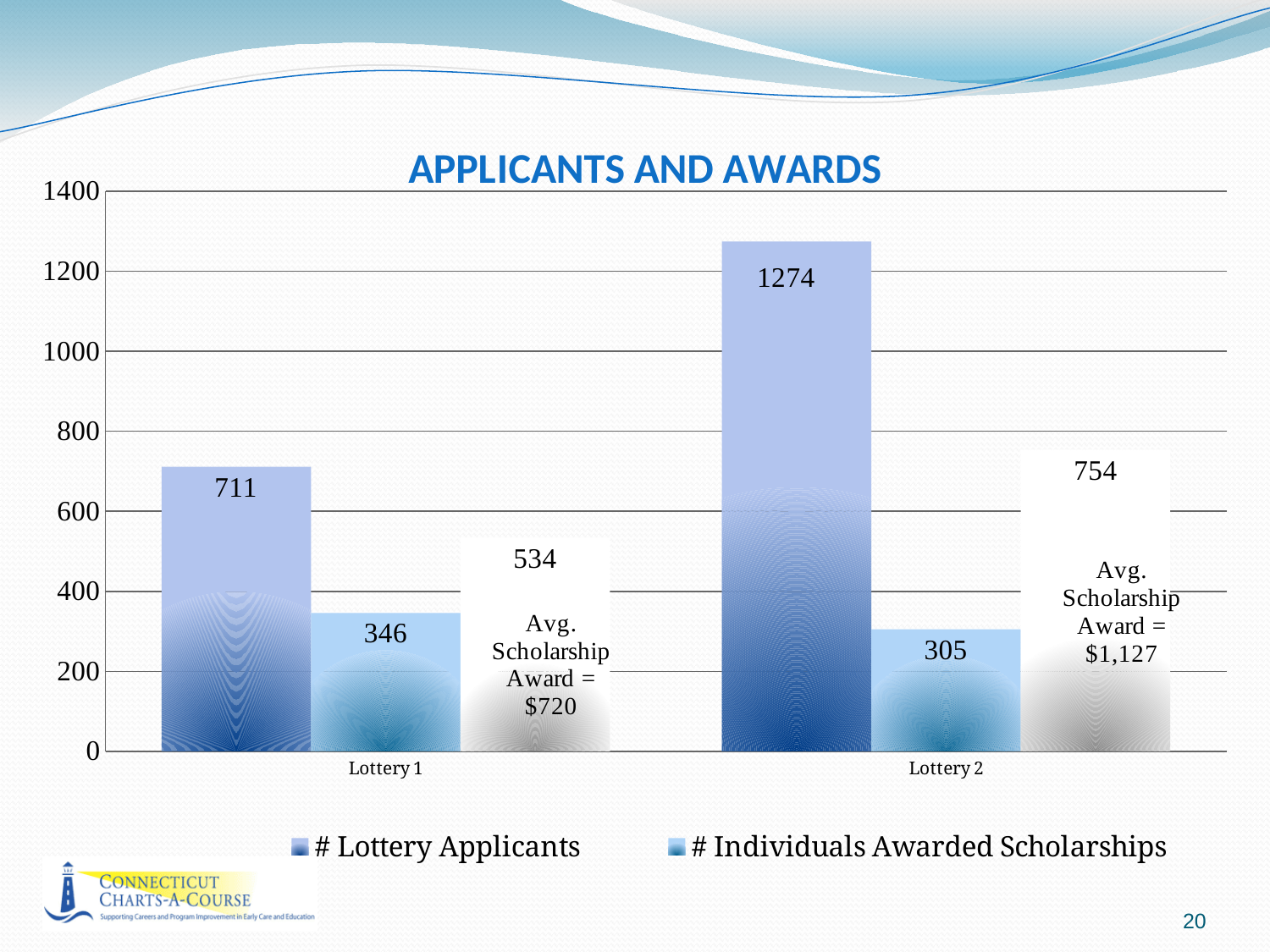
Which lottery has the lower number of Individuals Awarded Scholarships? Lottery 2 What type of chart is shown on the slide? Bar chart What is the number of Individuals Awarded Scholarships for Lottery 1? 346 What is the number of Individuals Awarded Scholarships for Lottery 2? 305 What is the number of Lottery Applicants for Lottery 1? 711 What is the average scholarship award shown for Lottery 2? $1,127 How many series does the legend list? 2 Which lottery has the higher number of Lottery Applicants? Lottery 2 What is the number of Lottery Applicants for Lottery 2? 1274 Is the number of Lottery Applicants for Lottery 2 greater or less than 1200? greater What is the average scholarship award shown for Lottery 1? $720 What is the difference between the number of Lottery Applicants for Lottery 2 and Lottery 1? 563